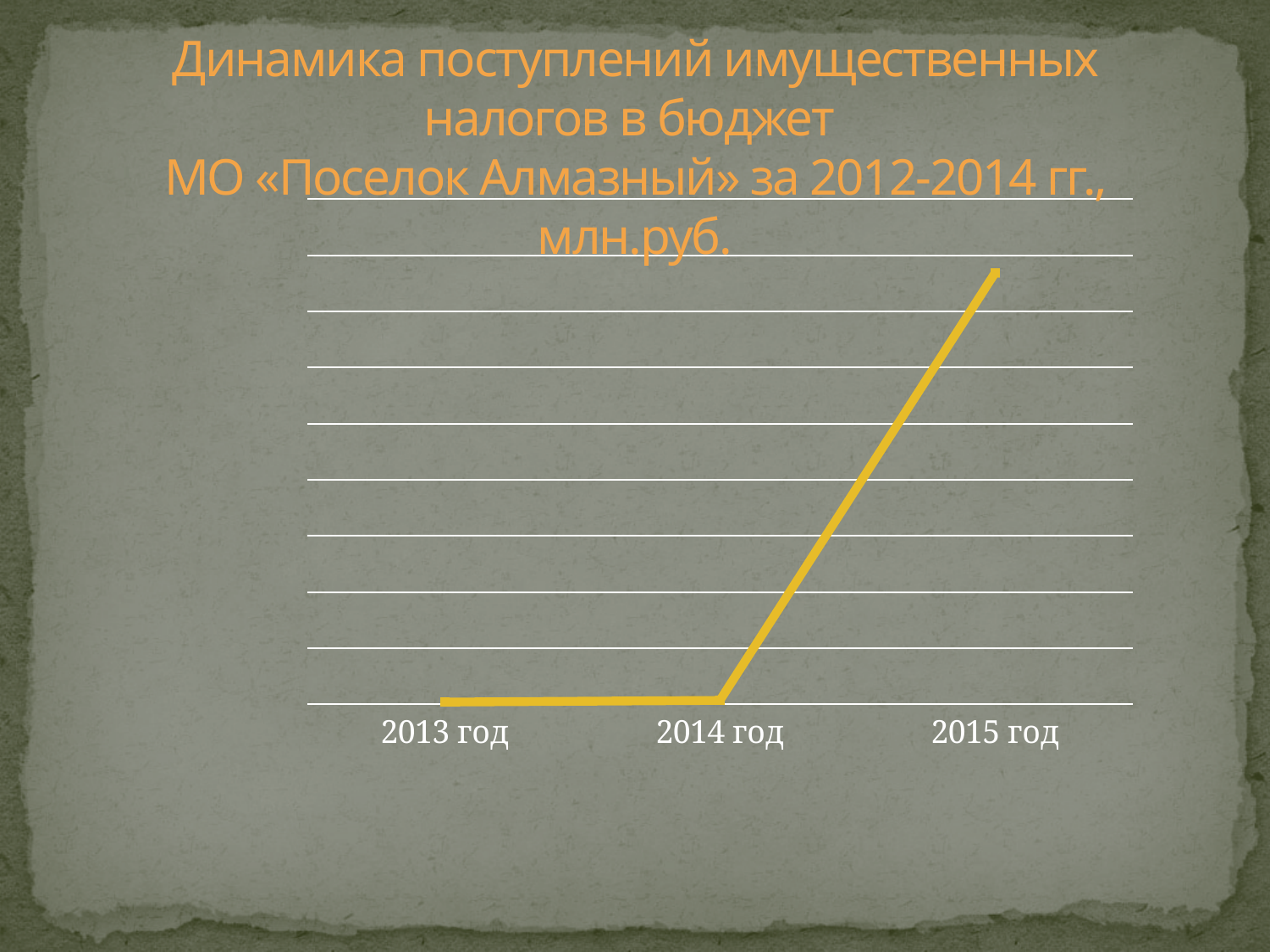
How many lines are plotted on the chart? 1 Do the values rise or fall from 2014 год to 2015 год? rise How many years are shown on the x axis of the chart? 3 What is the first year shown on the x axis of the chart? 2013 год What kind of chart is shown on the slide? line chart Overall, do the values rise or fall along the x axis from 2013 год to 2015 год? rise Which year has the highest value on the chart? 2015 год In what units are the values on the chart expressed, according to the title? млн.руб. Which is larger, the value for 2015 год or the value for 2014 год? 2015 год Which is larger, the value for 2015 год or the value for 2013 год? 2015 год